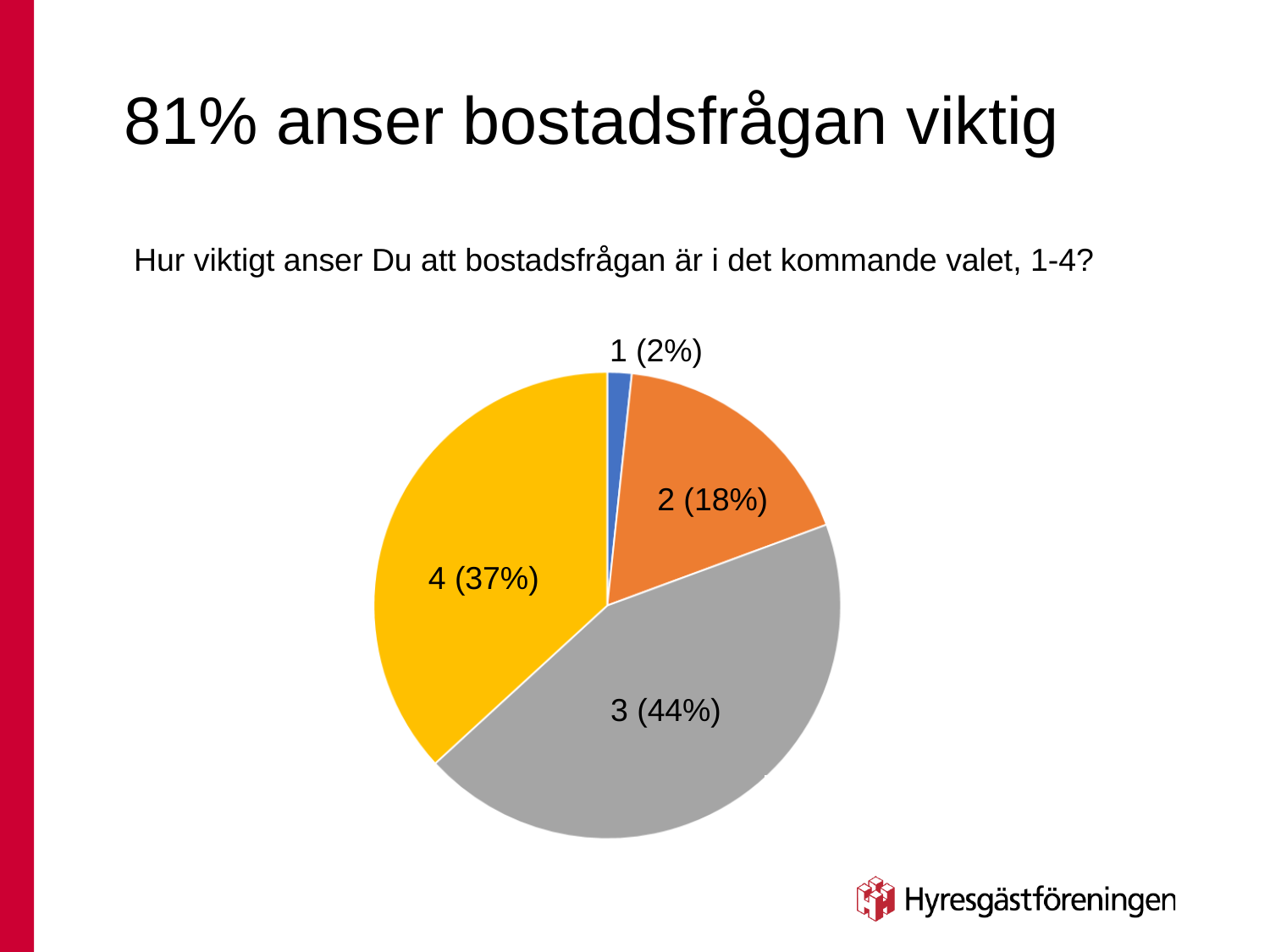
What kind of chart is shown on the slide? pie chart What share of the pie does category 2 have? 18% What share of the pie does category 4 have? 37% Which is larger, the share for category 2 or the share for category 4? 4 How many slices does the pie chart have? 4 What is the combined share of categories 3 and 4? 81% What colour is the slice for category 3? grey What share of the pie does category 1 have? 2% Which category has the largest slice of the pie? 3 Which category has the smallest slice of the pie? 1 What is the difference in percentage points between category 3 and category 4? 7